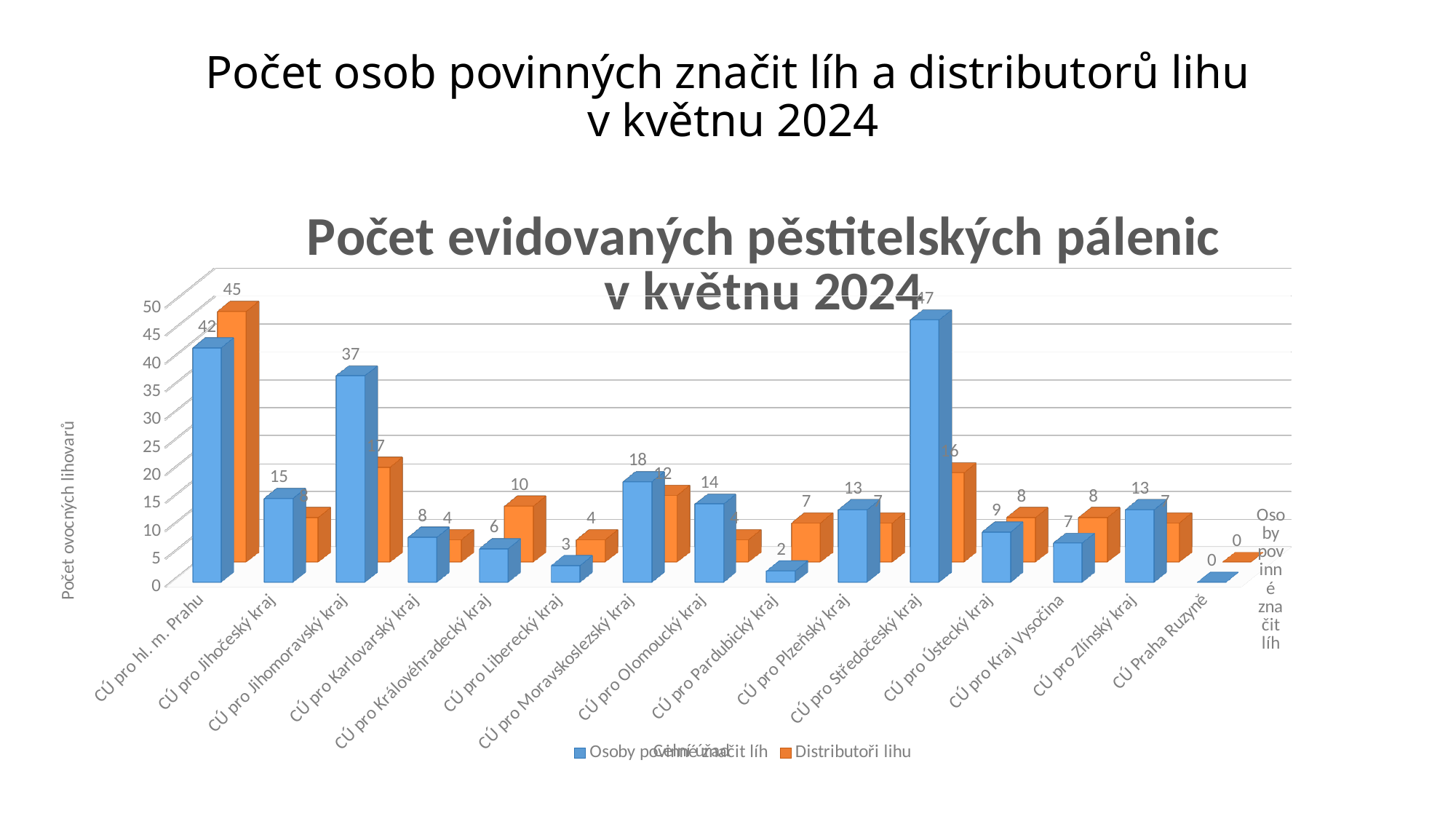
What is the difference between Osoby povinné značit líh and Distributoři lihu for CÚ pro Středočeský kraj? 31 What is the value of Osoby povinné značit líh for CÚ pro Moravskoslezský kraj? 18 What is the value of Osoby povinné značit líh for CÚ pro hl. m. Prahu? 42 How many series does the legend list? 2 Which customs office has the lowest value for Osoby povinné značit líh? CÚ Praha Ruzyně How many customs offices (categories) are shown on the x axis? 15 Which customs office has the highest value for Osoby povinné značit líh? CÚ pro Středočeský kraj What type of chart is shown on the slide? bar chart Which customs office has the highest value for Distributoři lihu? CÚ pro hl. m. Prahu For CÚ pro Královéhradecký kraj, which is larger: Osoby povinné značit líh or Distributoři lihu? Distributoři lihu What is the value of Distributoři lihu for CÚ pro Jihomoravský kraj? 17 Which colour represents the Distributoři lihu series? orange